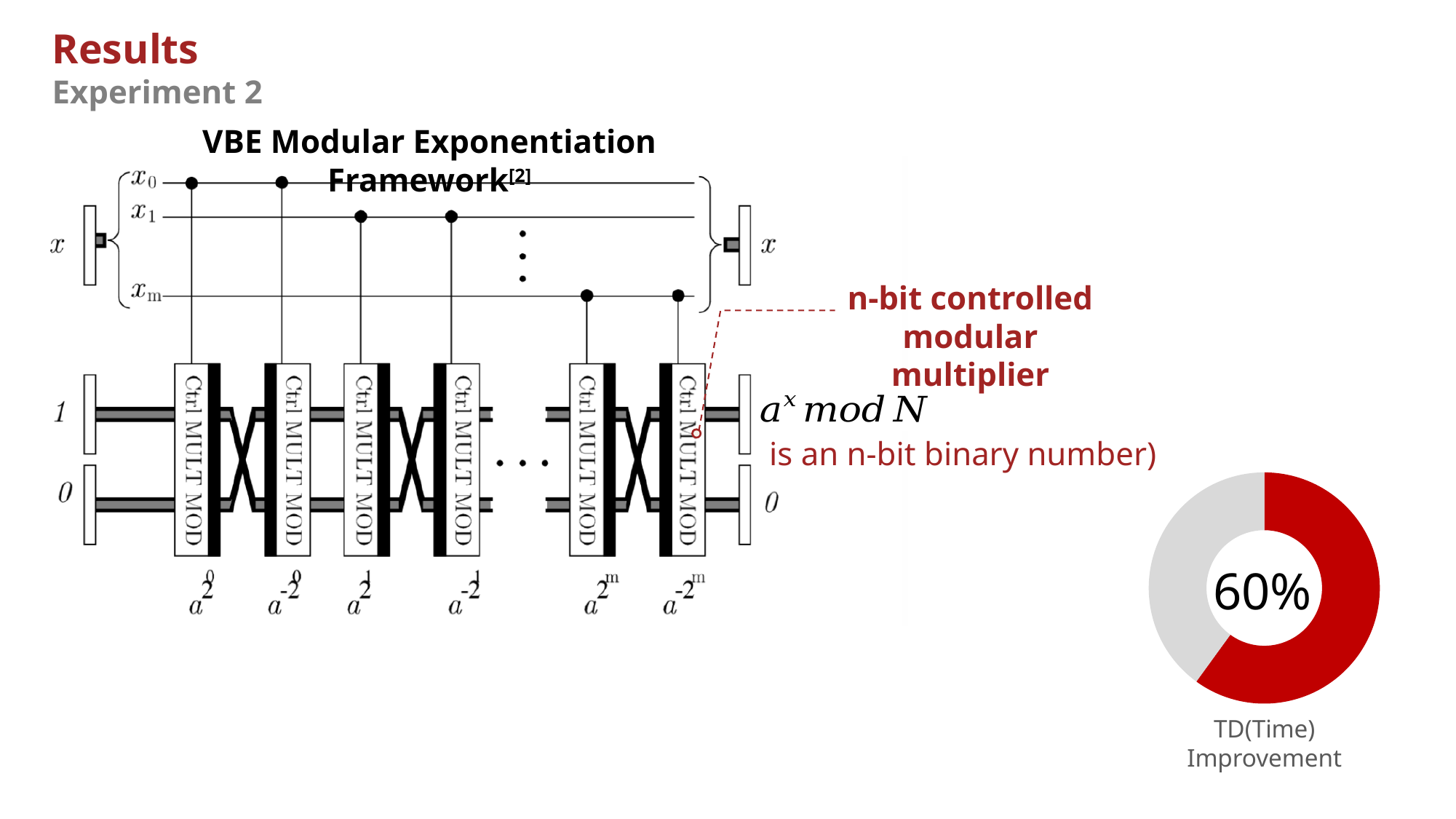
What kind of chart is shown at the bottom right of the slide? Doughnut (pie) chart What label appears beneath the doughnut chart? TD(Time) Improvement What is the TD(Time) Improvement shown in the doughnut chart? 60% What colour is the segment representing the 60% value in the doughnut chart? Red How many segments does the doughnut chart have? 2 What share of the doughnut chart does the red segment represent? 60% Is the value shown in the doughnut chart greater or less than 50%? greater Which segment of the doughnut chart is larger, the red one or the grey one? The red one What value is printed in the centre of the doughnut chart? 60%